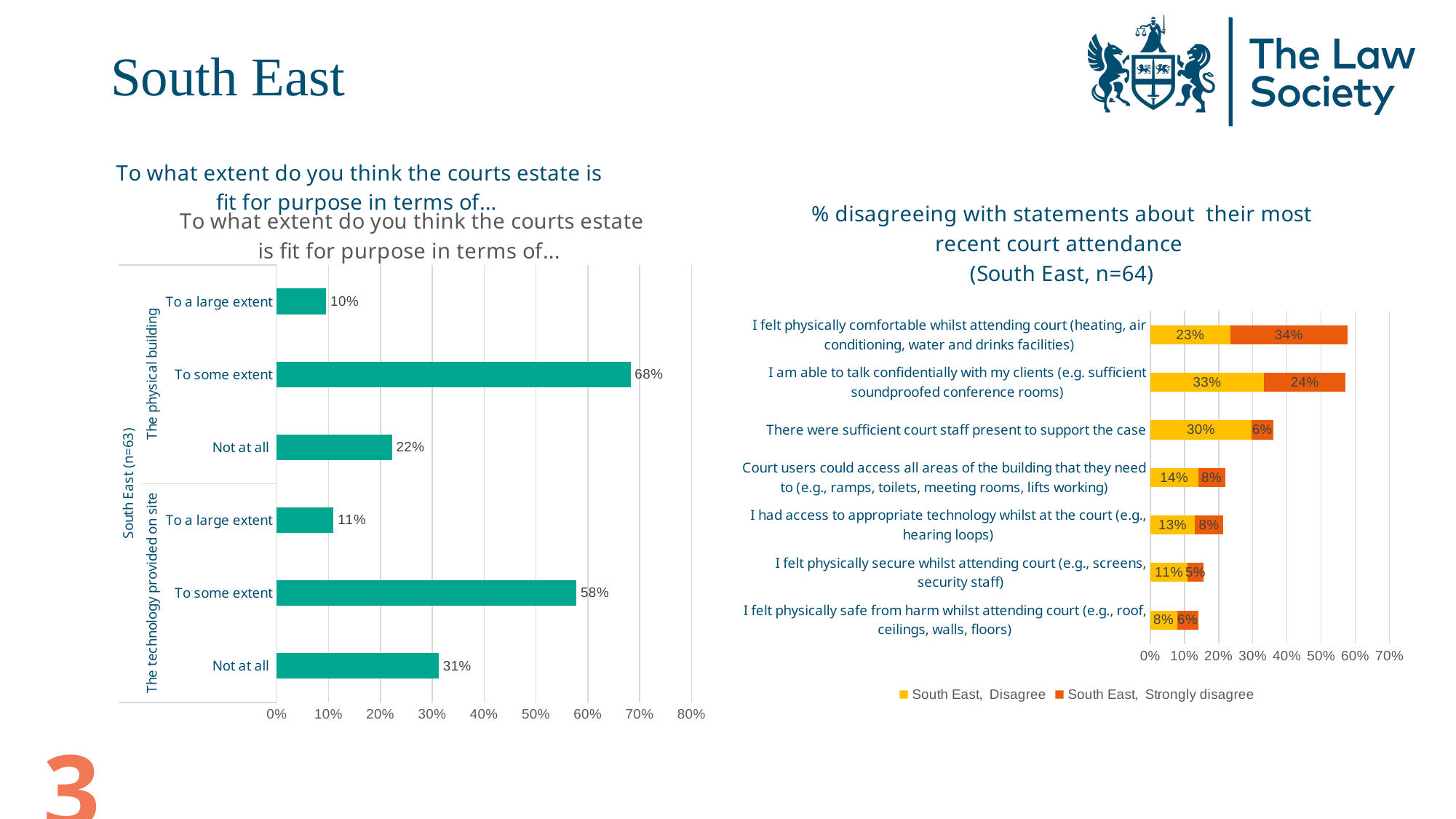
In the left chart, what is the difference between 'To some extent' for the physical building and 'To some extent' for the technology provided on site? 10 percentage points In the right chart, what percentage disagreed with 'There were sufficient court staff present to support the case'? 30% In the left chart, which response is lowest for the physical building? To a large extent What kind of chart is the left chart? Bar chart In the right chart, what is the total percentage disagreeing (Disagree plus Strongly disagree) with 'I am able to talk confidentially with my clients'? 57% How many statements are shown in the right chart? 7 In the left chart, which response is highest for the technology provided on site? To some extent In the right chart, what percentage strongly disagreed with 'I felt physically comfortable whilst attending court'? 34% How many series does the legend of the right chart list? 2 In the left chart, which is larger: 'Not at all' for the physical building or 'Not at all' for the technology provided on site? The technology provided on site In the left chart, what percentage said the technology provided on site is fit for purpose 'Not at all'? 31% In the left chart, what percentage said the physical building is fit for purpose 'To some extent'? 68%